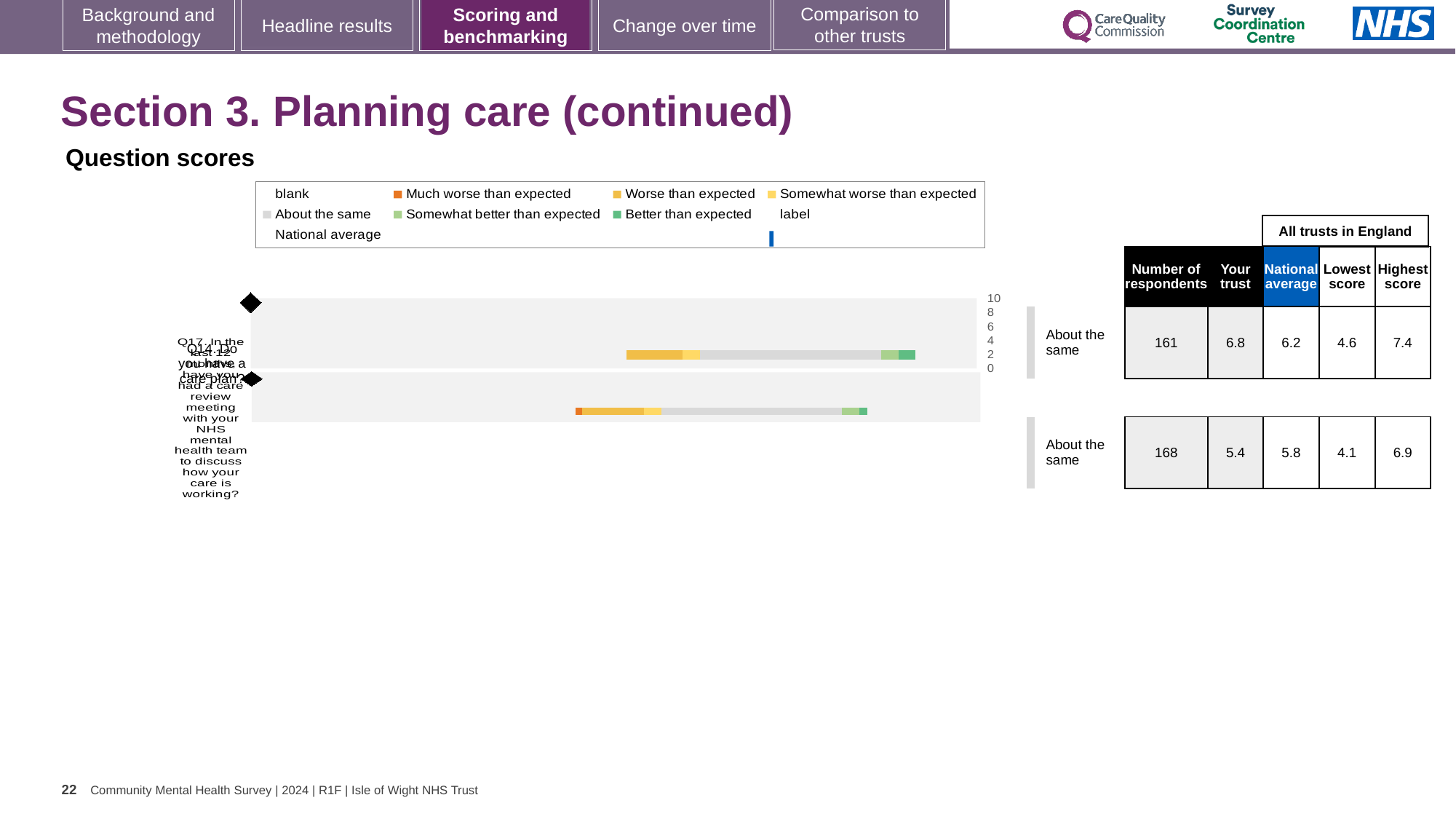
What is the difference between the highest and lowest scores for the bottom row (Q17)? 2.8 What is the 'Your trust' score for the top row (Q14, Do you have a care plan?)? 6.8 How many respondents are listed for the bottom row (Q17)? 168 What benchmark category is shown next to both bars? About the same What is the national average for the bottom row (Q17, care review meeting)? 5.8 By how much does the 'Your trust' score exceed the national average for the top row (Q14)? 0.6 What is the highest score among all trusts in England for the top row (Q14)? 7.4 Which row has the larger 'Your trust' score, the top row (Q14) or the bottom row (Q17)? Top row (Q14) What colour does the legend use for the national average marker? Blue What is the lowest score among all trusts in England for the bottom row (Q17)? 4.1 How many question bars are plotted in the chart? 2 What kind of chart is shown under 'Question scores'? Bar chart